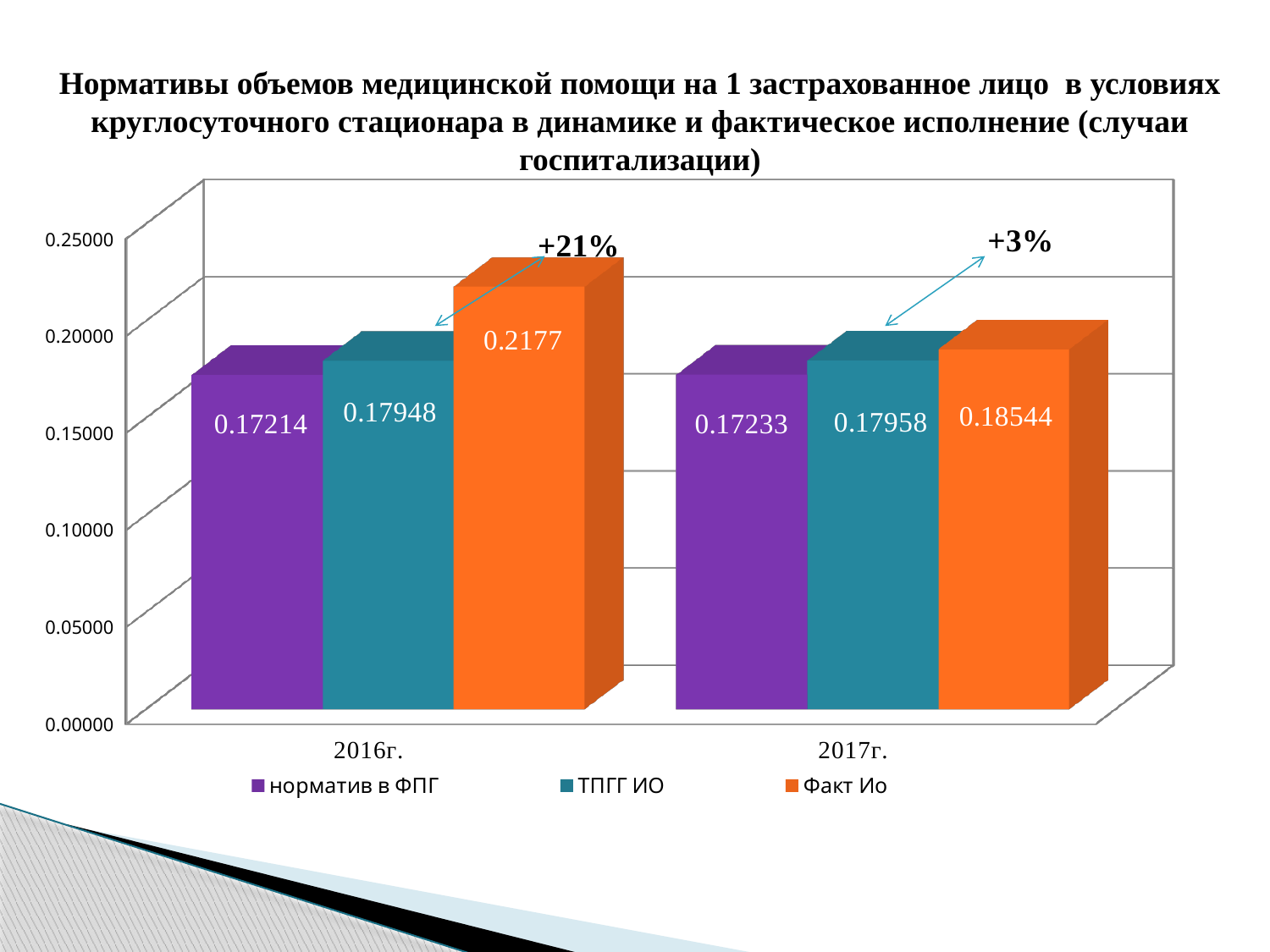
What is the difference between Факт Ио and ТПГГ ИО in 2016г.? 0.03822 How many series does the legend list? 3 What kind of chart is shown on the slide? bar chart Which series has the highest value in 2016г.? Факт Ио What is the value of норматив в ФПГ for 2016г.? 0.17214 Which is larger: Факт Ио in 2016г. or Факт Ио in 2017г.? Факт Ио in 2016г. What is the value of ТПГГ ИО for 2017г.? 0.17958 Which series has the lowest value in 2017г.? норматив в ФПГ What is the value of Факт Ио for 2017г.? 0.18544 What is the value of Факт Ио for 2016г.? 0.2177 Is the value of Факт Ио for 2016г. greater or less than 0.20000? greater What is the difference between Факт Ио in 2016г. and Факт Ио in 2017г.? 0.03226